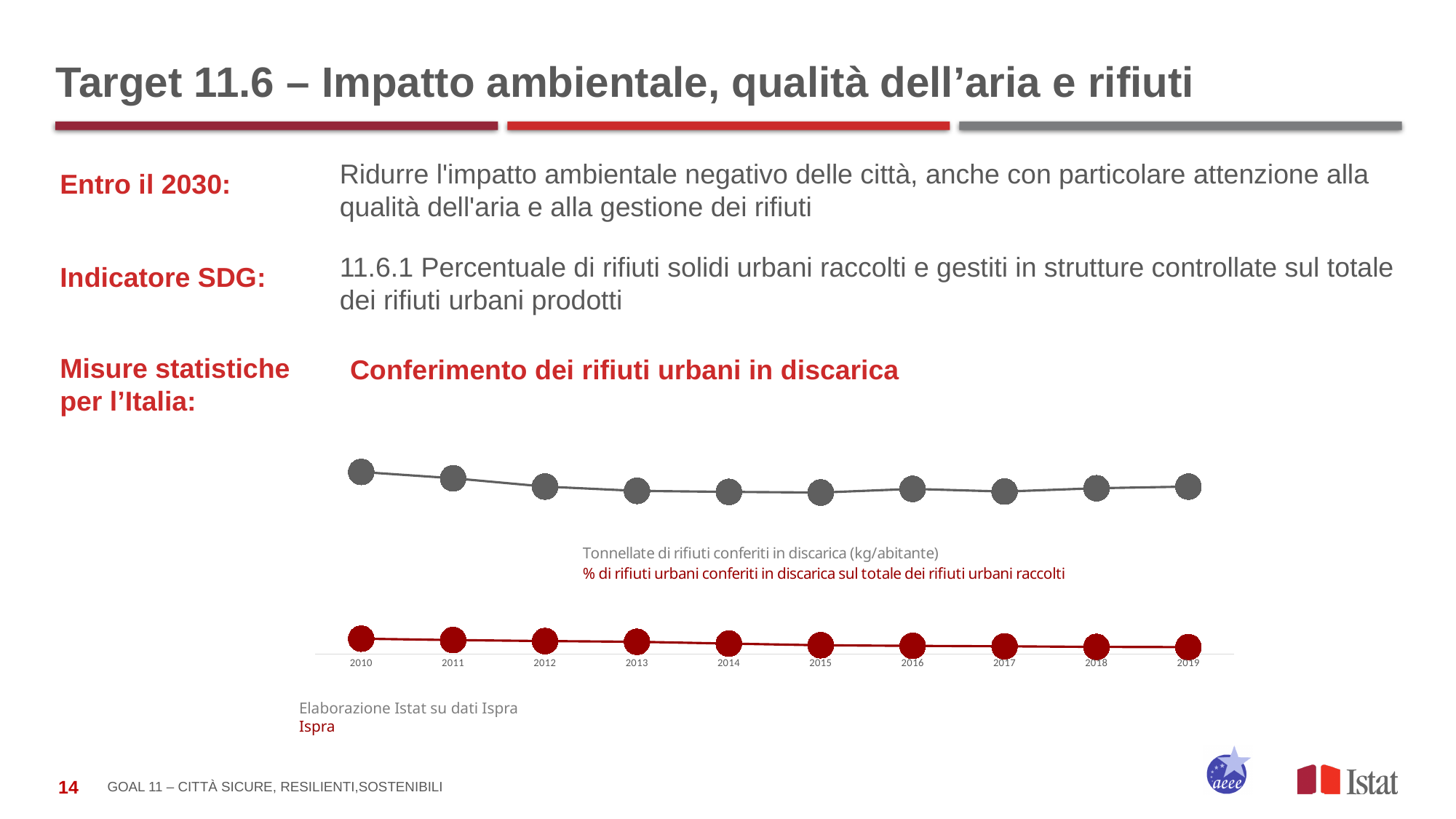
For the '% di rifiuti urbani conferiti in discarica sul totale dei rifiuti urbani raccolti' series, is the value in 2010 or in 2019 larger? 2010 Does the 'Tonnellate di rifiuti conferiti in discarica (kg/abitante)' series rise or fall between 2010 and 2015? Fall What is the last year shown on the x axis of the chart? 2019 For the 'Tonnellate di rifiuti conferiti in discarica (kg/abitante)' series, is the value in 2010 or in 2019 larger? 2010 What kind of chart is shown on the slide? Line chart Does the '% di rifiuti urbani conferiti in discarica sul totale dei rifiuti urbani raccolti' series rise or fall from 2010 to 2019? Fall In which year is the '% di rifiuti urbani conferiti in discarica sul totale dei rifiuti urbani raccolti' series at its highest? 2010 In which year is the 'Tonnellate di rifiuti conferiti in discarica (kg/abitante)' series at its highest? 2010 How many years are plotted along the x axis of the chart? 10 What is the first year shown on the x axis of the chart? 2010